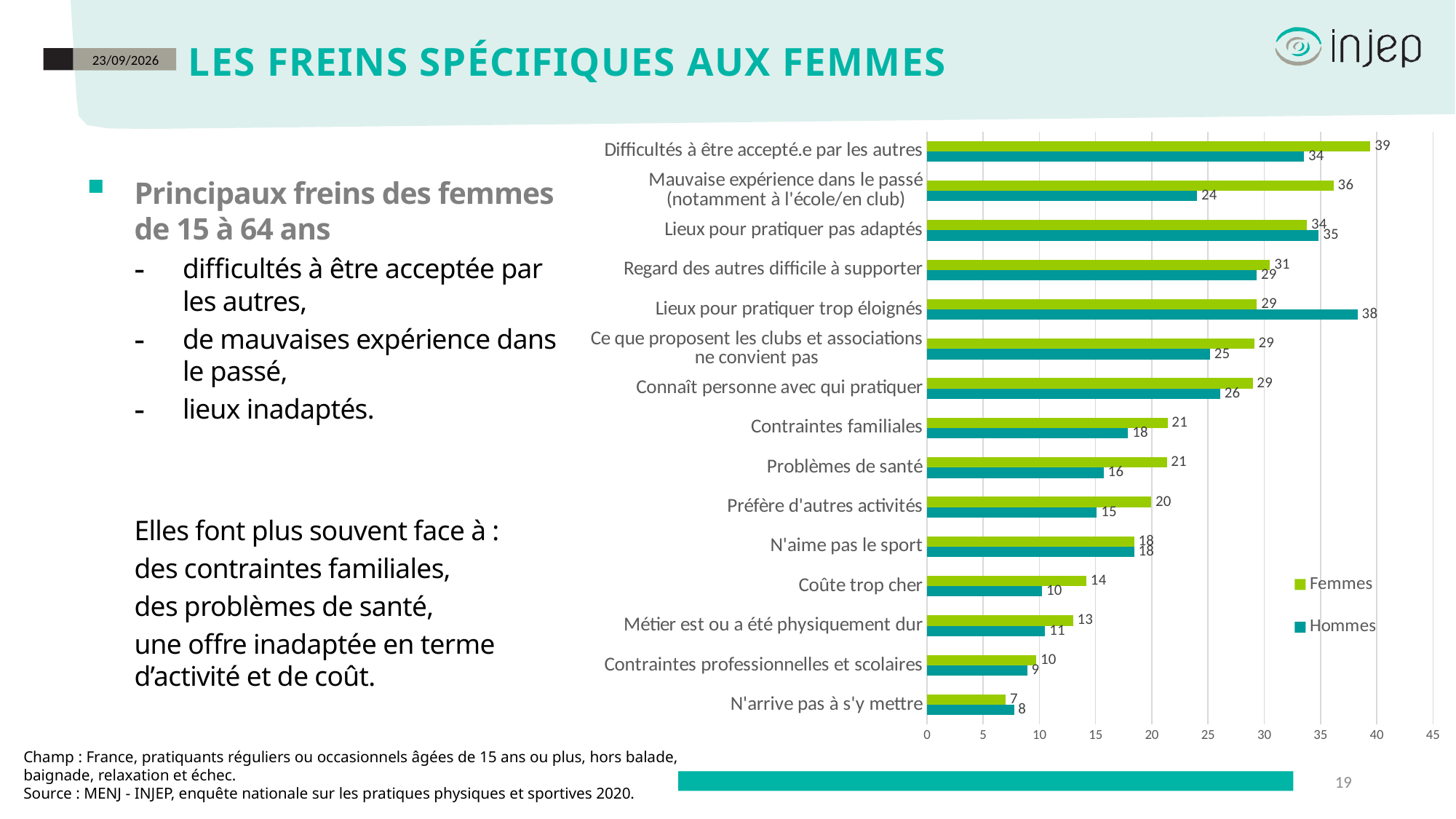
What is the value for Hommes for "Lieux pour pratiquer trop éloignés"? 38 Which colour represents the Femmes series in the chart? Green What is the value for Hommes for "Problèmes de santé"? 16 What is the value for Femmes for "Difficultés à être accepté.e par les autres"? 39 Which category has the lowest value for Hommes? N'arrive pas à s'y mettre Which category has the highest value for Femmes? Difficultés à être accepté.e par les autres How many categories (freins) are plotted on the chart? 15 For "Lieux pour pratiquer trop éloignés", which is larger: the Femmes value or the Hommes value? Hommes What kind of chart is shown on the slide? Bar chart How many series does the legend list? 2 What is the difference between the Femmes and Hommes values for "Mauvaise expérience dans le passé (notamment à l'école/en club)"? 12 What is the difference between the Femmes and Hommes values for "Coûte trop cher"? 4